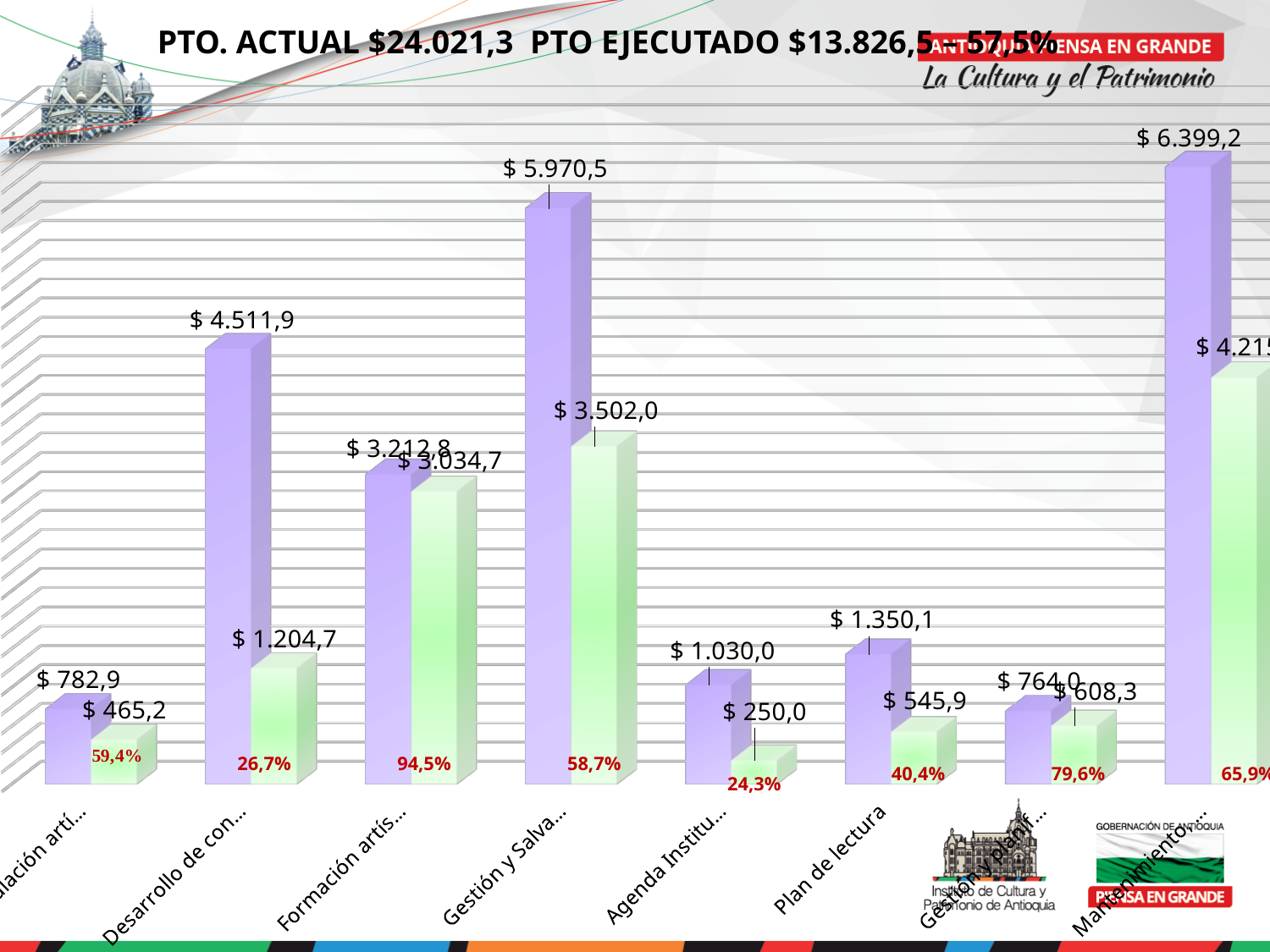
What is the lowest value labelled on any green bar in the chart? $ 250,0 What is the highest value labelled on any purple bar in the chart? $ 6.399,2 How many categories are plotted along the x axis of the chart? 8 What kind of chart is shown on the slide? bar chart What is the value of the purple bar for Plan de lectura? $ 1.350,1 What percentage is printed below the bars for Plan de lectura? 40,4% What is the lowest percentage printed below the bars in the chart? 24,3% What is the value of the green bar for Plan de lectura? $ 545,9 What total executed budget (PTO EJECUTADO) is stated in the slide title? $13.826,5 Which is larger: the purple bar for Plan de lectura or the purple bar for the category immediately to its left (Agenda Institu...)? Plan de lectura What is the difference between the purple bar and the green bar for Plan de lectura? $ 804,2 What is the highest percentage printed below the bars in the chart? 94,5%